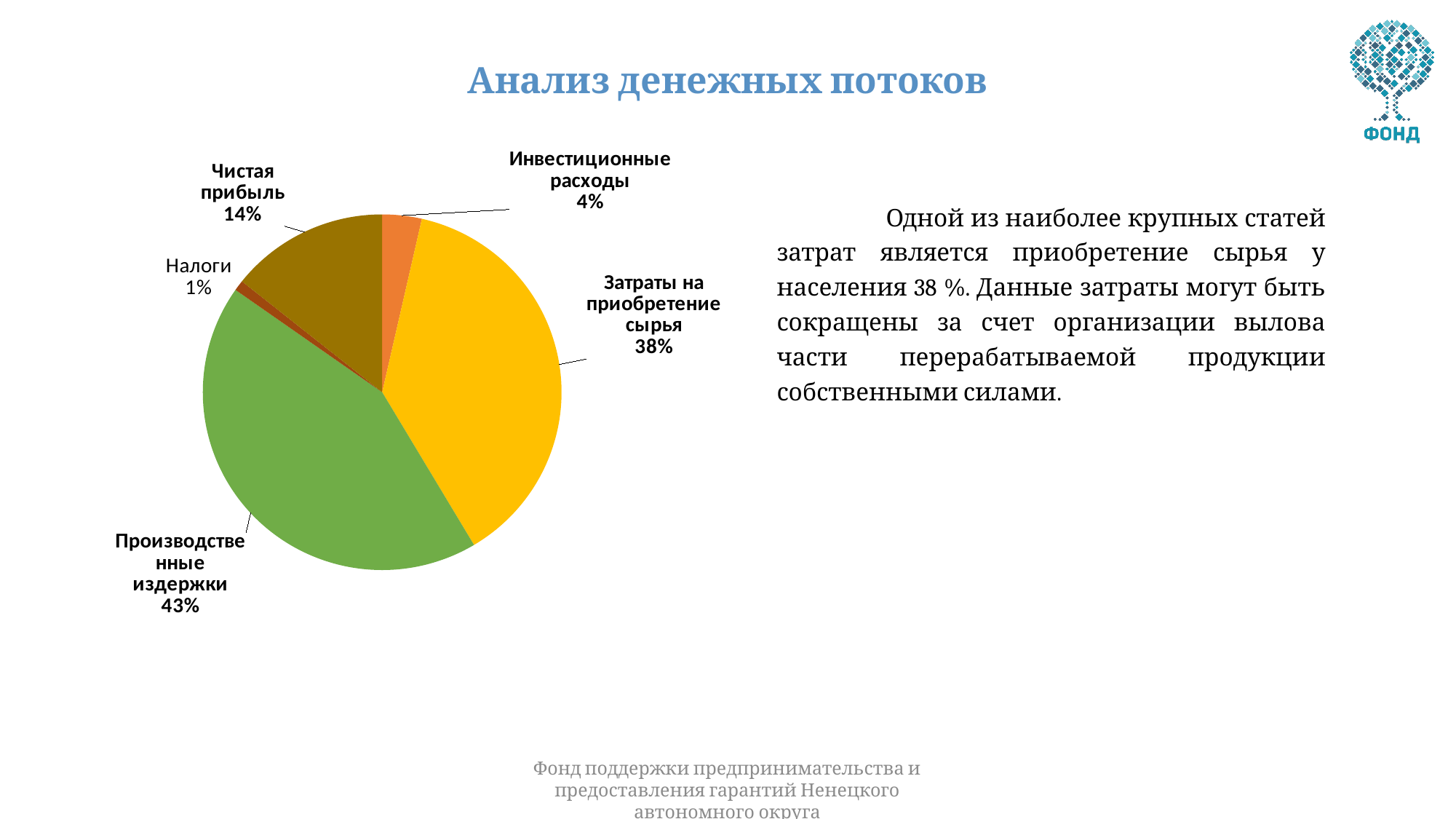
What is the value shown for Инвестиционные расходы? 4% How many slices does the pie chart have? 5 What kind of chart is shown on the slide? pie chart What is the difference between the shares of Производственные издержки and Затраты на приобретение сырья? 5% Which category has the largest slice of the pie? Производственные издержки What is the value shown for Налоги? 1% What share of the pie does Затраты на приобретение сырья take? 38% What is the value shown for Чистая прибыль? 14% Which is larger, Чистая прибыль or Инвестиционные расходы? Чистая прибыль Which category has the smallest slice of the pie? Налоги What share of the pie does Производственные издержки take? 43% What is the title of the slide containing the pie chart? Анализ денежных потоков